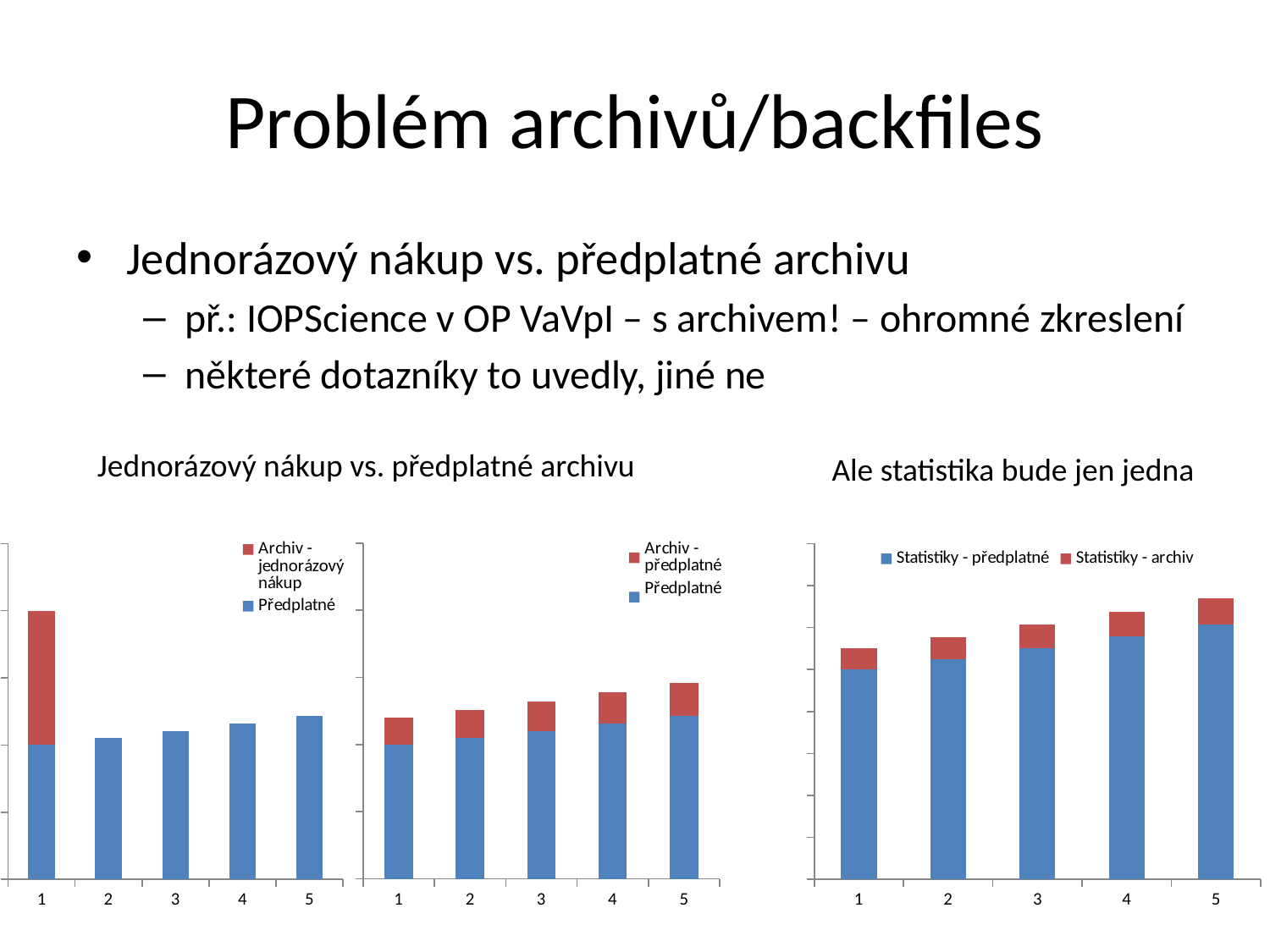
In the left chart, which category is the only one with an 'Archiv - jednorázový nákup' segment? 1 How many series does the legend of the left chart list? 2 In the left chart, do the 'Předplatné' values rise or fall from category 2 to category 5? rise In the right chart, which category has the highest stacked bar? 5 In the middle chart, which category has the lowest stacked bar? 1 In the middle chart, do the stacked bar totals rise or fall from category 1 to category 5? rise In the right chart, is the 'Statistiky - předplatné' value for category 5 larger or smaller than for category 1? larger In the left chart, which category has the tallest stacked bar? 1 What kind of chart is the left chart on the slide? bar chart What is the title of the right chart? Ale statistika bude jen jedna How many series does the legend of the middle chart list? 2 How many categories are shown on the x axis of the left chart? 5